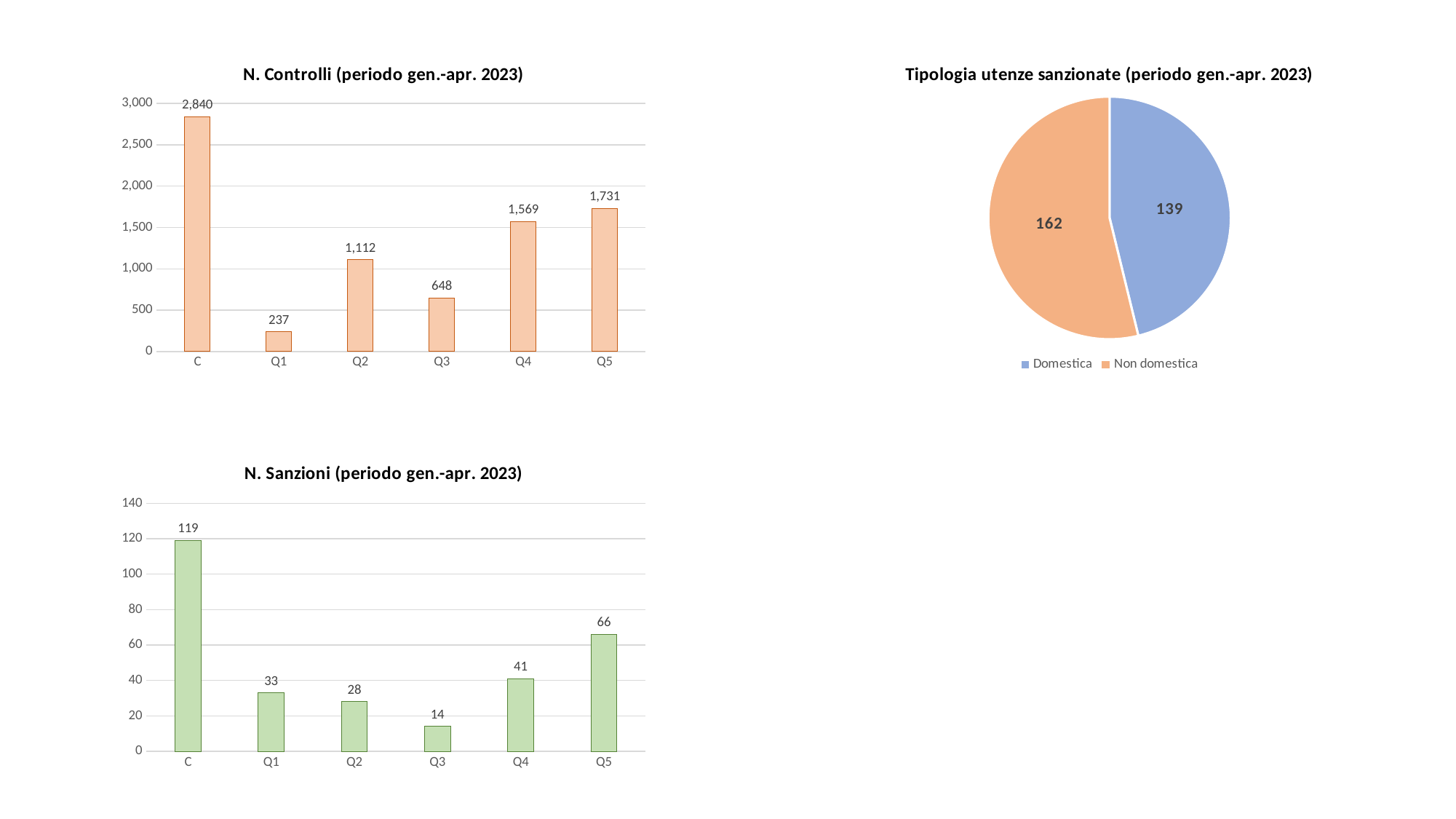
In the 'N. Controlli (periodo gen.-apr. 2023)' chart, which category has the lowest value? Q1 What kind of chart is 'N. Sanzioni (periodo gen.-apr. 2023)'? bar chart In the 'N. Sanzioni (periodo gen.-apr. 2023)' chart, what is the difference between the values for C and Q5? 53 In the 'N. Controlli (periodo gen.-apr. 2023)' chart, which category has the highest value? C In the 'Tipologia utenze sanzionate (periodo gen.-apr. 2023)' pie chart, what is the value for Non domestica? 162 In the 'Tipologia utenze sanzionate (periodo gen.-apr. 2023)' pie chart, what is the total of the two slices? 301 In the 'N. Controlli (periodo gen.-apr. 2023)' chart, how many categories are shown on the x axis? 6 In the 'N. Controlli (periodo gen.-apr. 2023)' chart, what is the difference between the values for Q5 and Q2? 619 How many entries does the legend of the 'Tipologia utenze sanzionate (periodo gen.-apr. 2023)' pie chart list? 2 In the 'N. Sanzioni (periodo gen.-apr. 2023)' chart, which is larger, the value for Q1 or the value for Q2? Q1 In the 'N. Controlli (periodo gen.-apr. 2023)' chart, what is the value for Q4? 1,569 In the 'N. Sanzioni (periodo gen.-apr. 2023)' chart, what is the value for Q3? 14